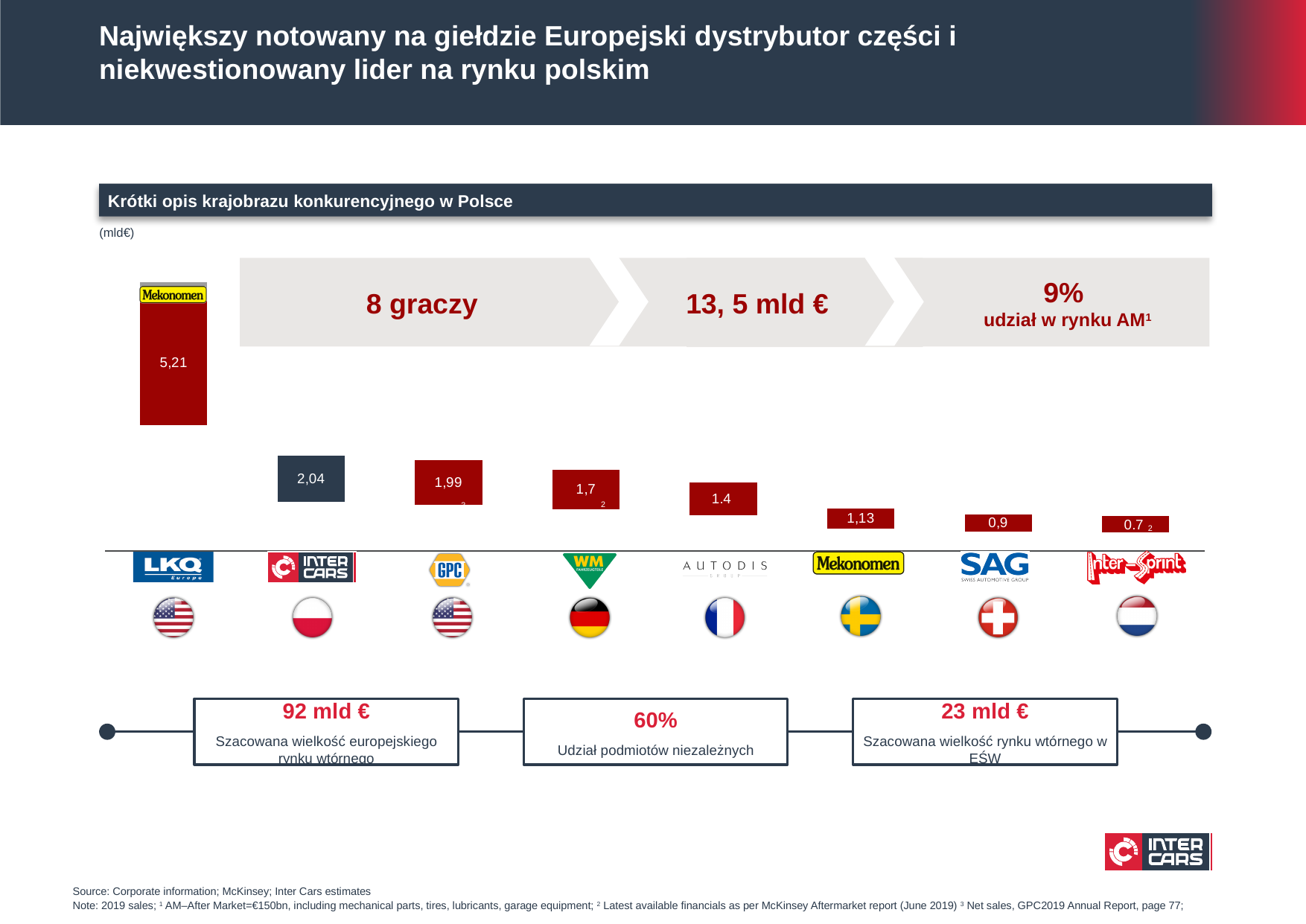
Which has a larger value, WM or Autodis? WM Do the bar values rise or fall from left to right across the chart? fall Which player has the lowest value in the chart? Inter-Sprint In what unit are the chart values expressed, as stated above the chart? mld€ What is the value of the tallest bar in the chart? 5,21 What is the value shown for Autodis? 1.4 What kind of chart is shown under 'Krótki opis krajobrazu konkurencyjnego w Polsce'? bar chart What is the difference between the values for Inter Cars and GPC? 0,05 How many players (bars) are shown in the chart? 8 What is the value shown for GPC? 1,99 What is the value shown for Inter Cars? 2,04 What is the value shown for SAG? 0,9